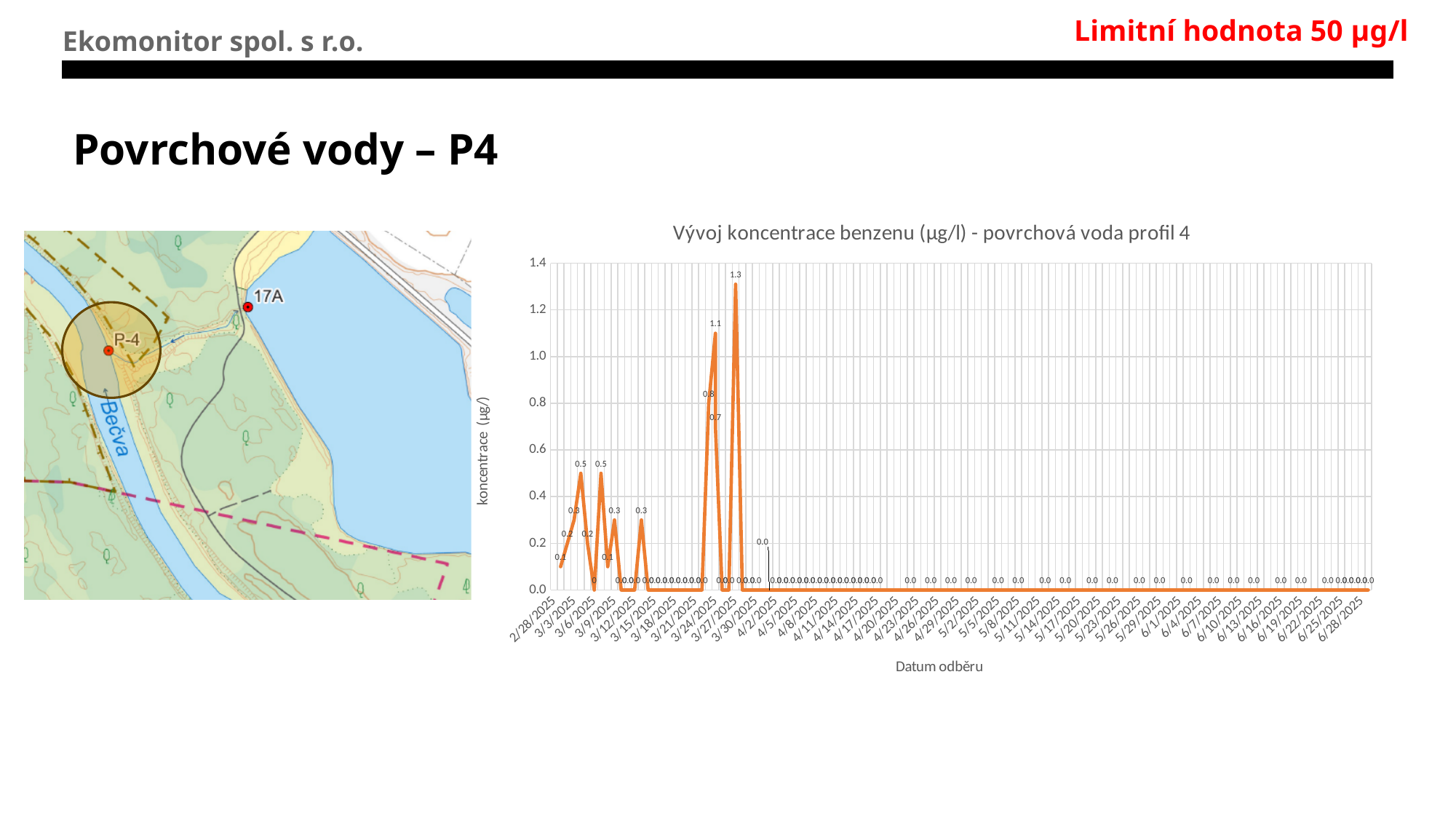
Which is larger: the peak labelled 0.8 or the peak labelled 0.7? 0.8 Do the concentration values rise or fall overall from the start of the period to the end? fall What is the title of the chart? Vývoj koncentrace benzenu (µg/l) - povrchová voda profil 4 What is the concentration value at the last date, 6/28/2025? 0.0 What type of chart is shown on the slide? line chart What is the lowest value plotted on the chart? 0.0 Is the highest value on the chart greater or less than 1.2? greater What is the concentration value at the first date, 2/28/2025? 0.1 What is the highest benzene concentration value plotted on the chart? 1.3 How many data points on the chart exceed 1.0? 2 What is the label of the vertical axis of the chart? koncentrace (µg/l) What is the difference between the two highest peaks on the chart (1.3 and 1.1)? 0.2